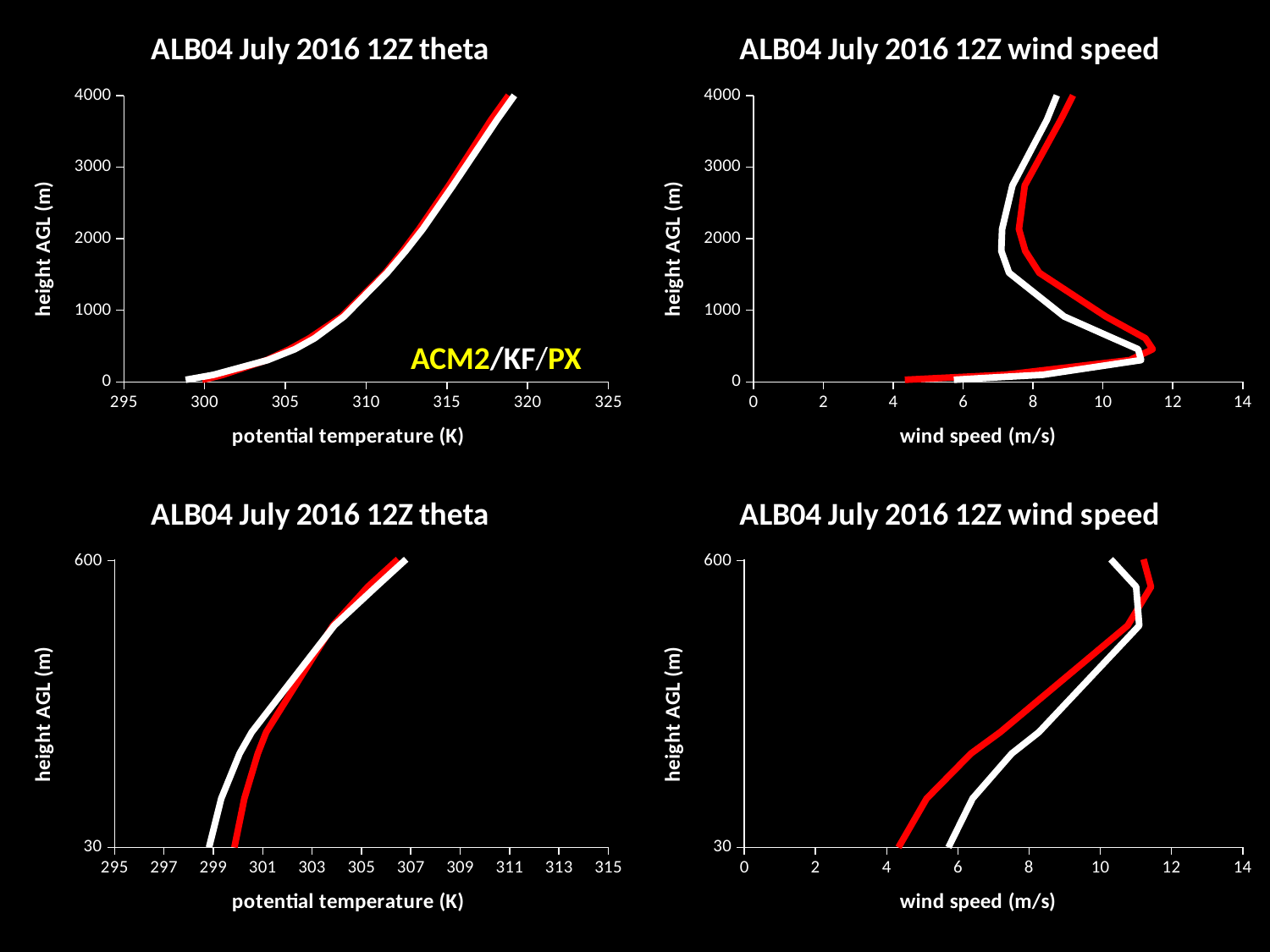
What is the x-axis label of the top-right chart? wind speed (m/s) In the top-right wind speed chart, at 1000 m, which line shows the higher wind speed, the red (PX) or the white (KF)? red (PX) In the top-right wind speed chart, is the peak wind speed greater or less than 10 m/s? greater In the top-left theta chart, is the potential temperature at 0 m greater or less than 305 K? less How many model names are listed in the legend 'ACM2/KF/PX' on the top-left chart? 3 In the top-right wind speed chart, is the red (PX) wind speed at 0 m greater or less than 6 m/s? less What kind of chart is the top-left 'ALB04 July 2016 12Z theta' chart? line chart In the bottom-right wind speed chart, does wind speed generally increase or decrease from 30 m up to 600 m? increase In the top-left theta chart, does potential temperature increase or decrease as height increases? increase In the bottom-right wind speed chart, at 30 m, which line shows the higher wind speed, the white (KF) or the red (PX)? white (KF)